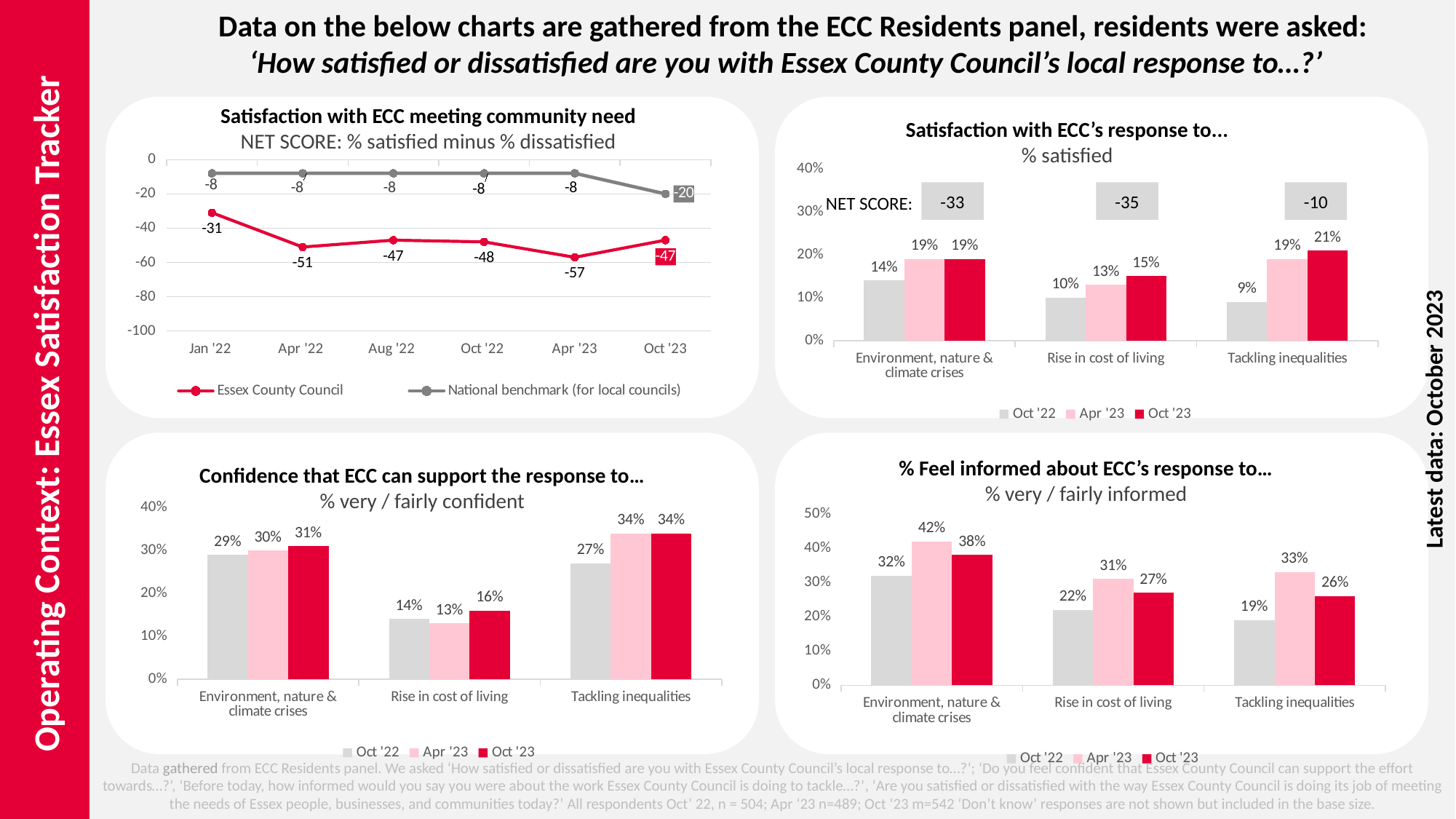
In the 'Satisfaction with ECC meeting community need' chart, what type of chart is shown? Line chart In the '% Feel informed about ECC's response to...' chart, what is the Oct '22 value for Tackling inequalities? 19% In the 'Satisfaction with ECC's response to...' chart, what is the difference between the Oct '23 and Oct '22 values for Tackling inequalities? 12% In the 'Satisfaction with ECC's response to...' chart, what is the NET SCORE shown for Rise in cost of living? -35 In the 'Confidence that ECC can support the response to...' chart, what is the Apr '23 value for Environment, nature & climate crises? 30% How many series does the legend list in the '% Feel informed about ECC's response to...' chart? 3 In the 'Confidence that ECC can support the response to...' chart, which category has the lowest Oct '23 value? Rise in cost of living In the 'Satisfaction with ECC's response to...' chart, what is the % satisfied for Tackling inequalities in Oct '23? 21% In the 'Satisfaction with ECC meeting community need' chart, what is the Essex County Council net score for Apr '23? -57 In the '% Feel informed about ECC's response to...' chart, which is larger for Rise in cost of living: Apr '23 or Oct '23? Apr '23 In the 'Satisfaction with ECC meeting community need' chart, at which date is the Essex County Council net score lowest? Apr '23 In the 'Satisfaction with ECC meeting community need' chart, what is the National benchmark value for Oct '23? -20